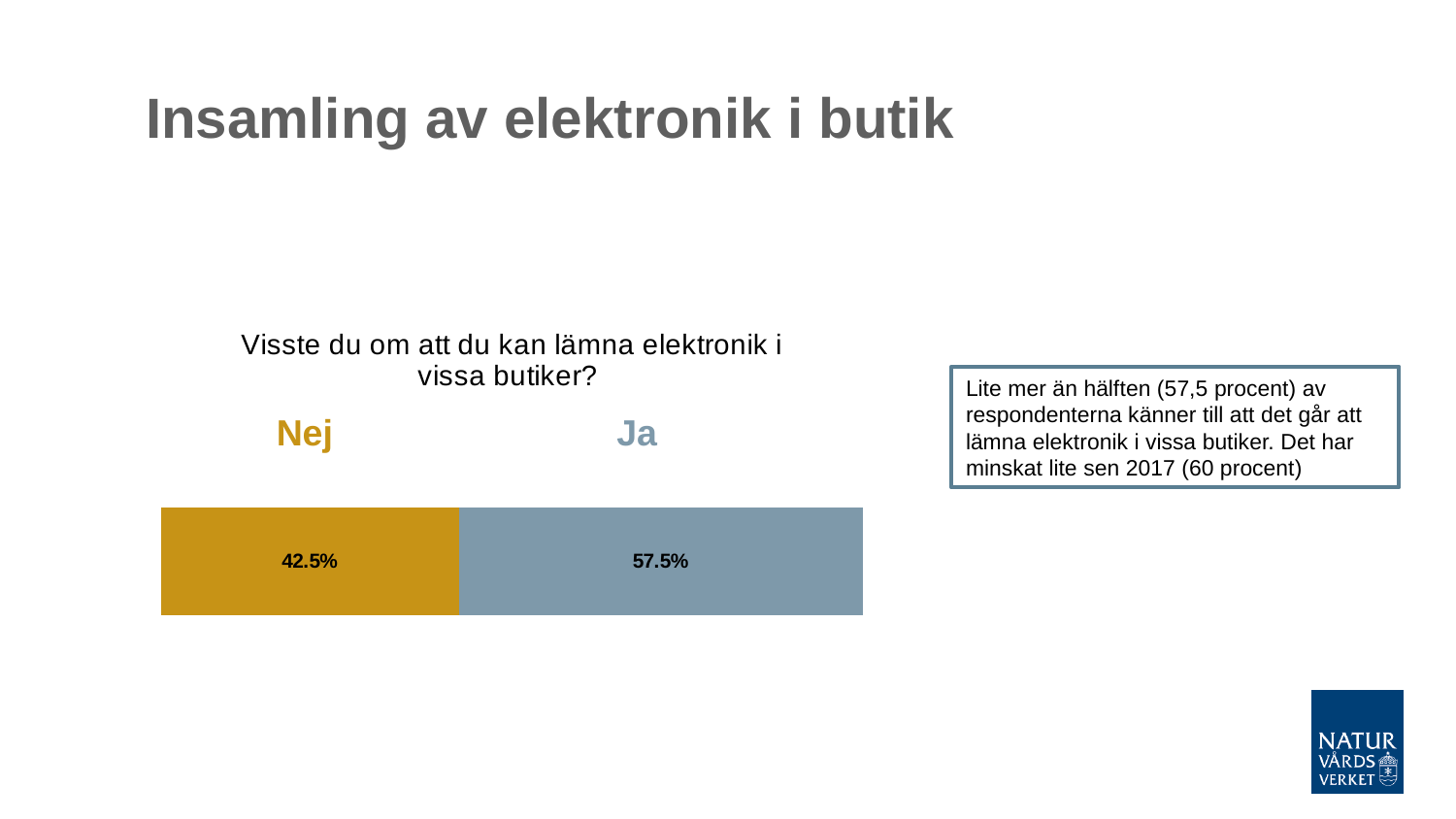
What is the title of the chart? Visste du om att du kan lämna elektronik i vissa butiker? Which category has the highest value, "Nej" or "Ja"? Ja What is the total of the two segments in the stacked bar? 100% How many categories are shown in the chart? 2 What is the value for "Nej" in the chart? 42.5% What is the difference between the values for "Ja" and "Nej"? 15% What colour is the "Nej" segment of the bar? yellow/gold Which category has the lowest value in the chart? Nej What is the value for "Ja" in the chart? 57.5% What kind of chart is shown on the slide? bar chart Is the value for "Ja" larger or smaller than the value for "Nej"? larger